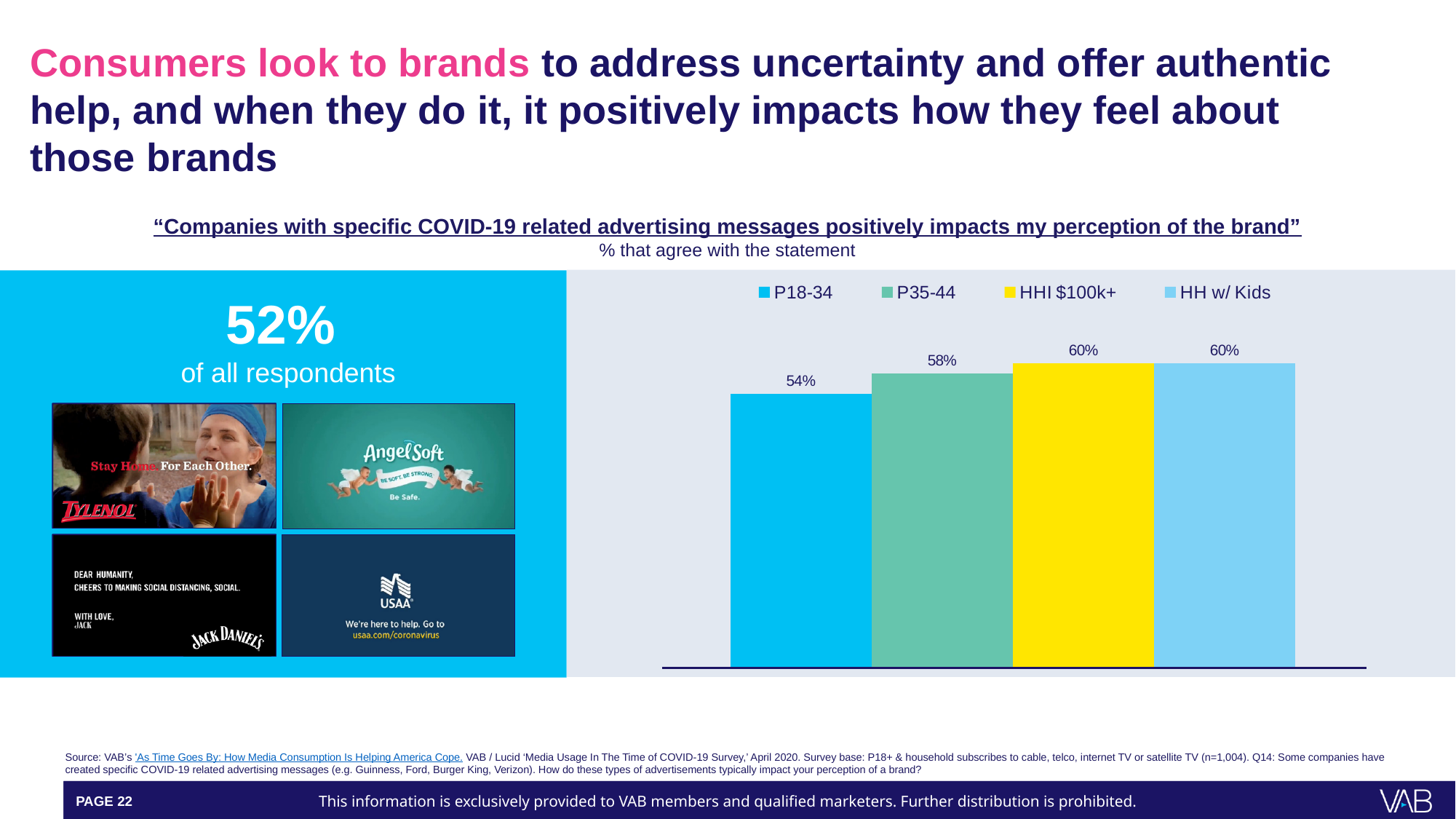
What is the value shown for HH w/ Kids? 60% What is the difference between the values for HHI $100k+ and P18-34? 6 percentage points How many entries does the chart legend list? 4 What is the difference between the values for P35-44 and P18-34? 4 percentage points Which group has the lowest percentage agreeing with the statement? P18-34 How many bars are plotted in the chart? 4 What percentage of P35-44 agree with the statement? 58% Which is larger, the value for P35-44 or the value for P18-34? P35-44 What type of chart is shown on the slide? Bar chart What colour is the bar for HHI $100k+? Yellow What is the value shown for HHI $100k+? 60% What percentage of P18-34 agree with the statement? 54%